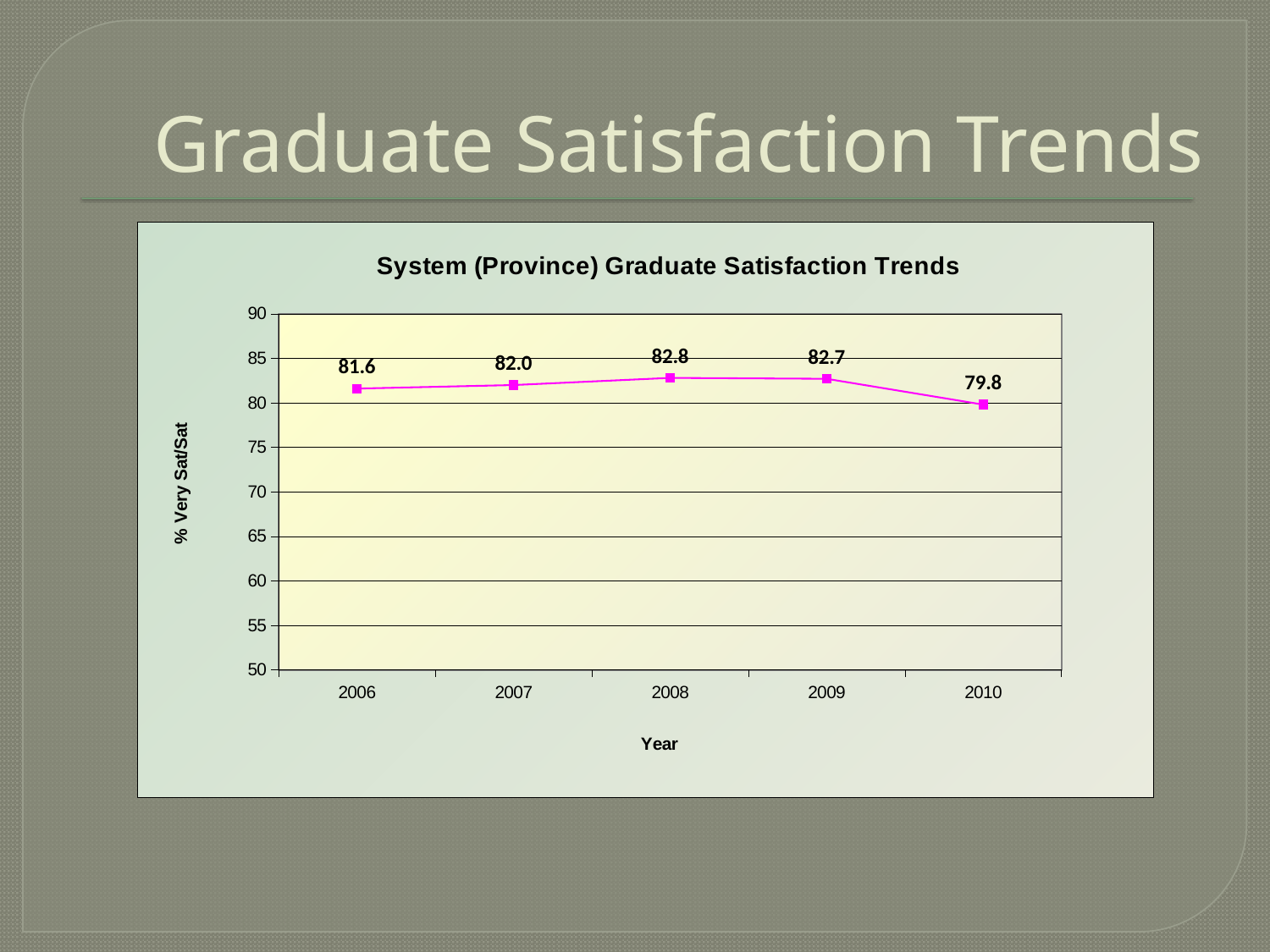
What is the difference between the values for 2006 and 2008? 1.2 What is the value for 2006? 81.6 Is the value for 2010 greater or less than 85? less What is the value for 2010? 79.8 What kind of chart is shown? line chart How many years are plotted on the chart? 5 What is the title of the chart? System (Province) Graduate Satisfaction Trends Which year has the highest value? 2008 What is the difference between the values for 2009 and 2010? 2.9 Which is larger, the value for 2007 or the value for 2010? 2007 Which year has the lowest value? 2010 What is the value for 2008? 82.8